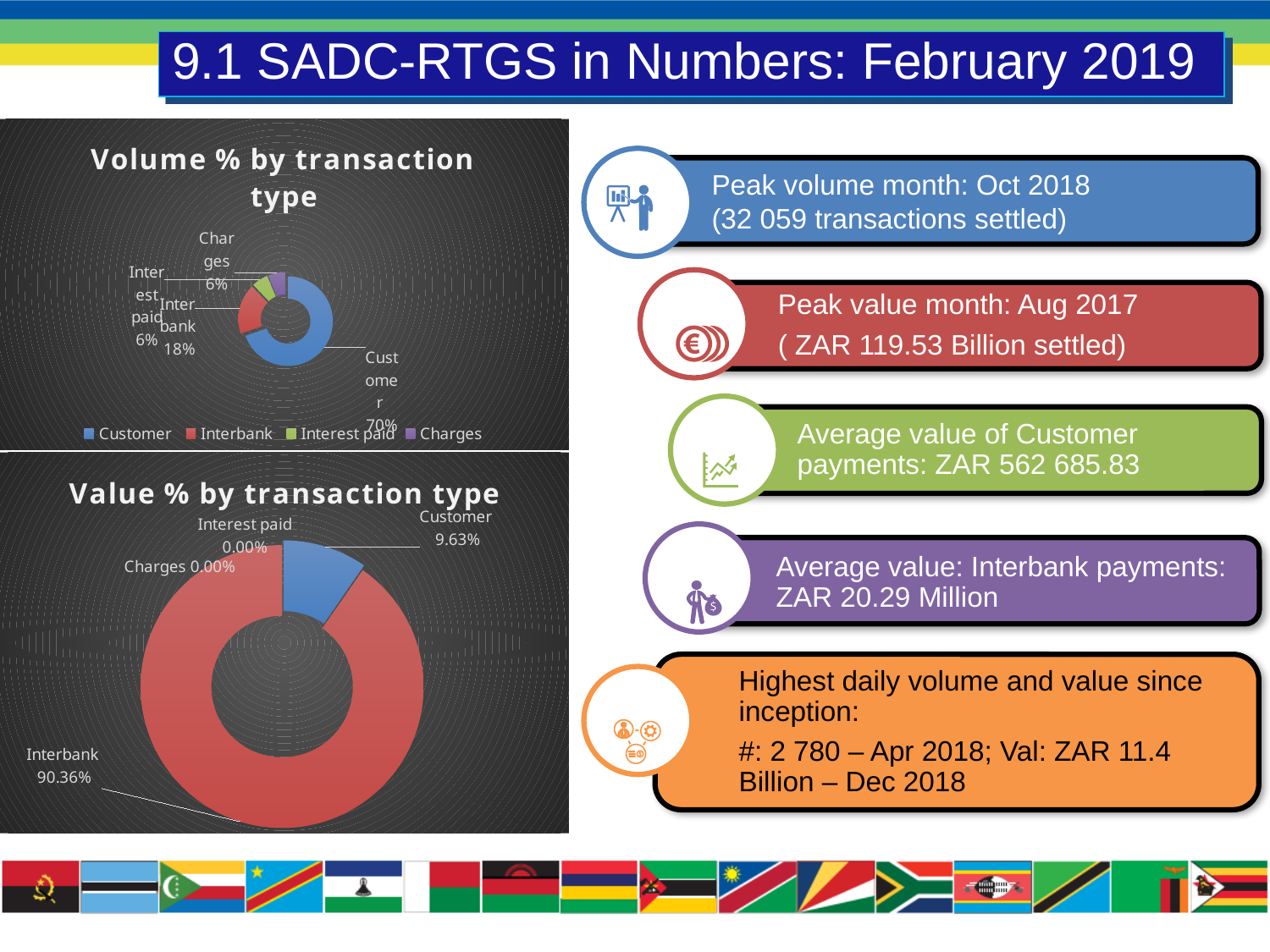
In the 'Value % by transaction type' chart, which transaction type has the largest share? Interbank In the 'Volume % by transaction type' chart, what is the difference between the Customer and Interbank shares? 52% In the 'Value % by transaction type' chart, what share does Charges have? 0.00% What kind of chart is 'Volume % by transaction type'? Doughnut chart In the 'Value % by transaction type' chart, what is the difference between the Interbank and Customer shares? 80.73% In the 'Value % by transaction type' chart, what share does Customer have? 9.63% In the 'Volume % by transaction type' chart, how many transaction types does the legend list? 4 In the 'Volume % by transaction type' chart, what share does Customer have? 70% In the 'Volume % by transaction type' chart, which transaction type has the largest share? Customer In the 'Value % by transaction type' chart, what share does Interbank have? 90.36% In the 'Value % by transaction type' chart, which is larger, Interbank or Customer? Interbank In the 'Volume % by transaction type' chart, what share does Interbank have? 18%